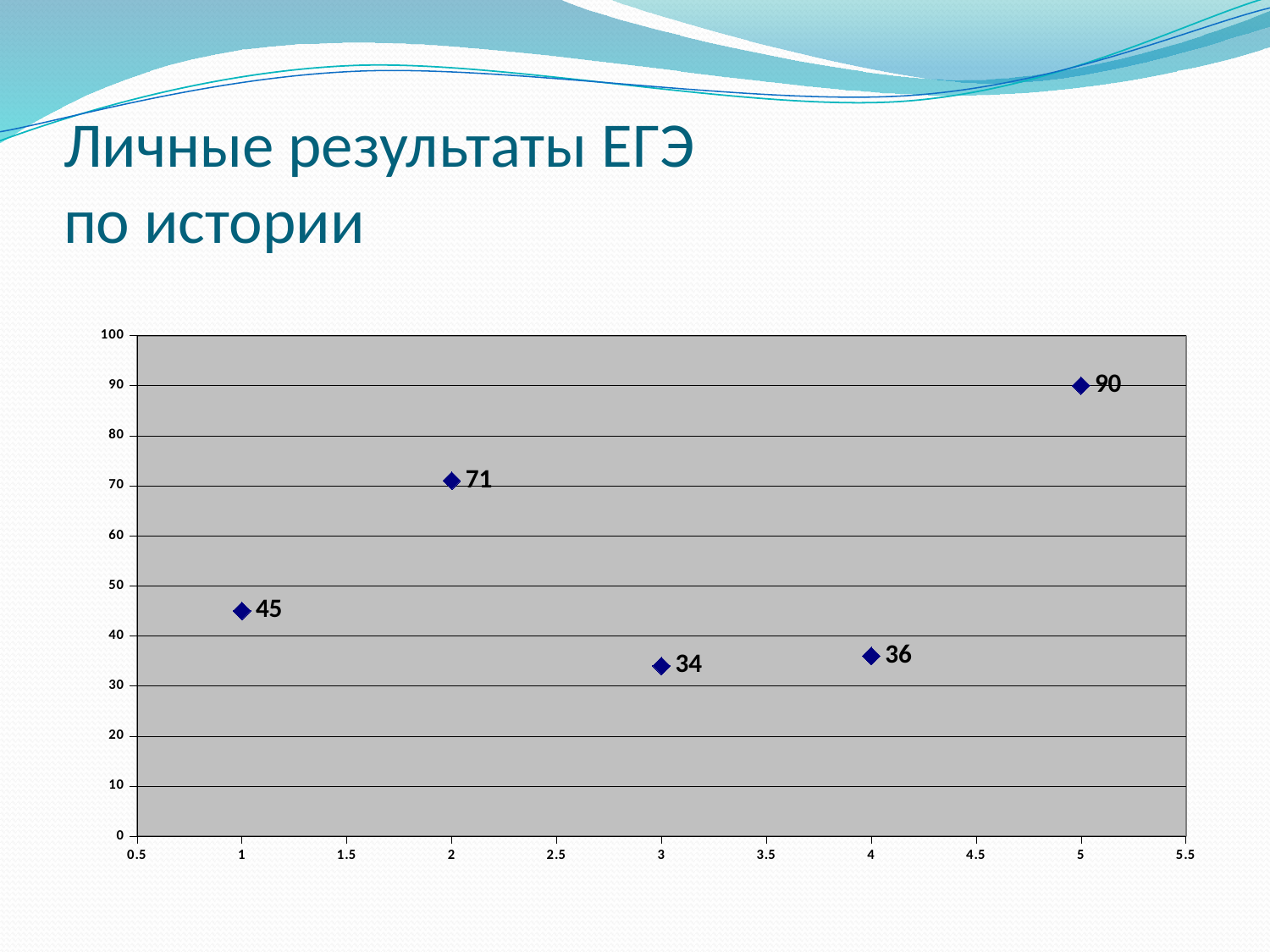
What is the value of the point at x = 3? 34 What is the value of the point at x = 4? 36 What is the difference between the values at x = 2 and x = 3? 37 Which is larger, the value at x = 1 or the value at x = 4? x = 1 What is the value of the point at x = 2? 71 What is the difference between the values at x = 5 and x = 1? 45 What kind of chart is shown on the slide? scatter chart How many data points are plotted on the chart? 5 At which x value is the lowest point plotted? 3 At which x value is the highest point plotted? 5 What is the value of the point at x = 5? 90 What is the value of the point at x = 1? 45